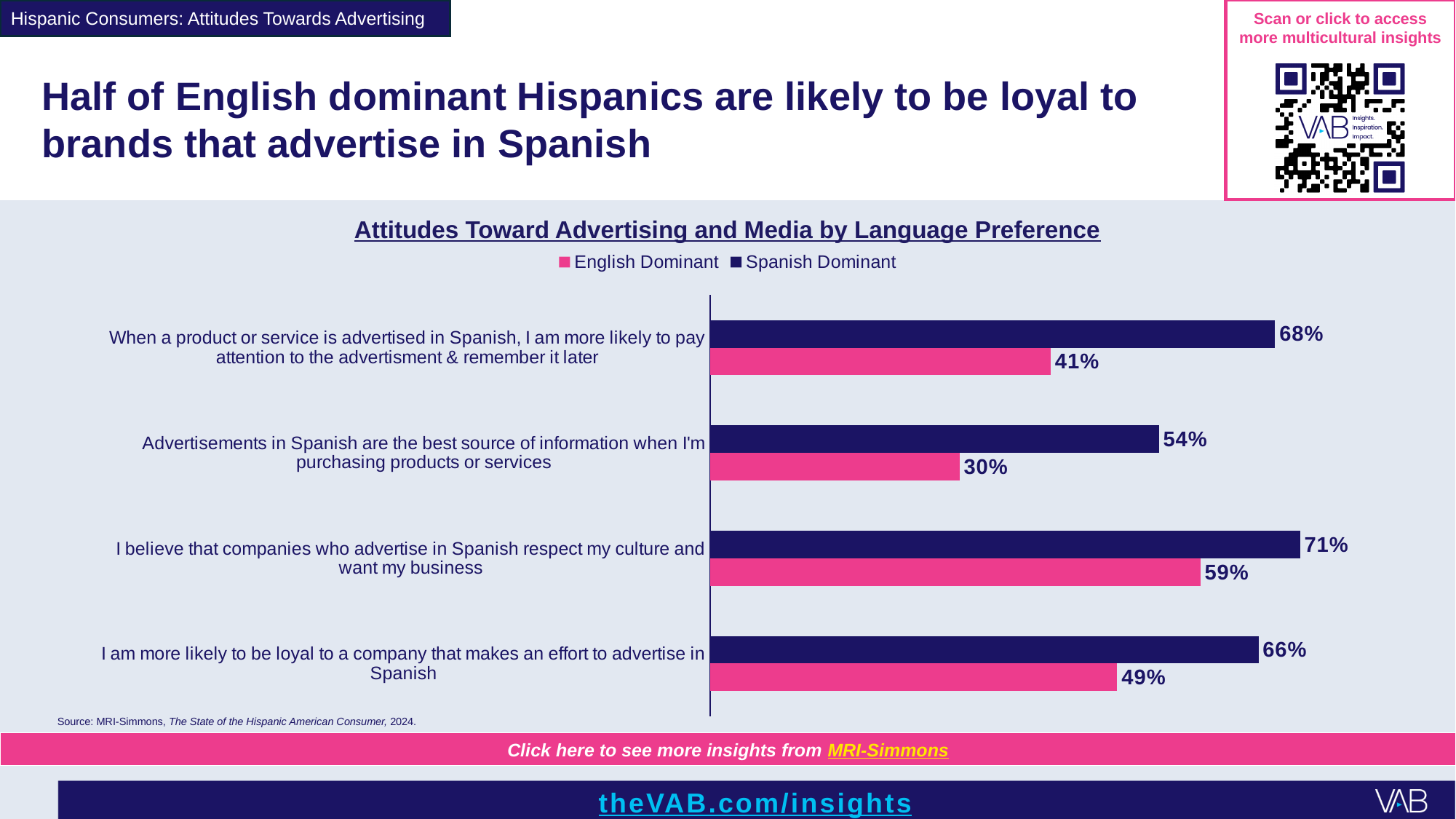
What percentage of English Dominant Hispanics believe companies who advertise in Spanish respect their culture and want their business? 59% What type of chart is shown on the slide? Bar chart What is the English Dominant value for 'Advertisements in Spanish are the best source of information when I'm purchasing products or services'? 30% What is the title of the chart? Attitudes Toward Advertising and Media by Language Preference How many statements (categories) are shown in the chart? 4 What percentage of Spanish Dominant Hispanics say they are more likely to pay attention to an ad in Spanish and remember it later? 68% How many series does the legend list? 2 What is the Spanish Dominant value for 'I am more likely to be loyal to a company that makes an effort to advertise in Spanish'? 66% For the loyalty statement, which group has the larger value: English Dominant or Spanish Dominant? Spanish Dominant What is the difference between the Spanish Dominant and English Dominant values for 'Advertisements in Spanish are the best source of information when I'm purchasing products or services'? 24% Which statement has the lowest English Dominant value? Advertisements in Spanish are the best source of information when I'm purchasing products or services Which statement has the highest Spanish Dominant value? I believe that companies who advertise in Spanish respect my culture and want my business